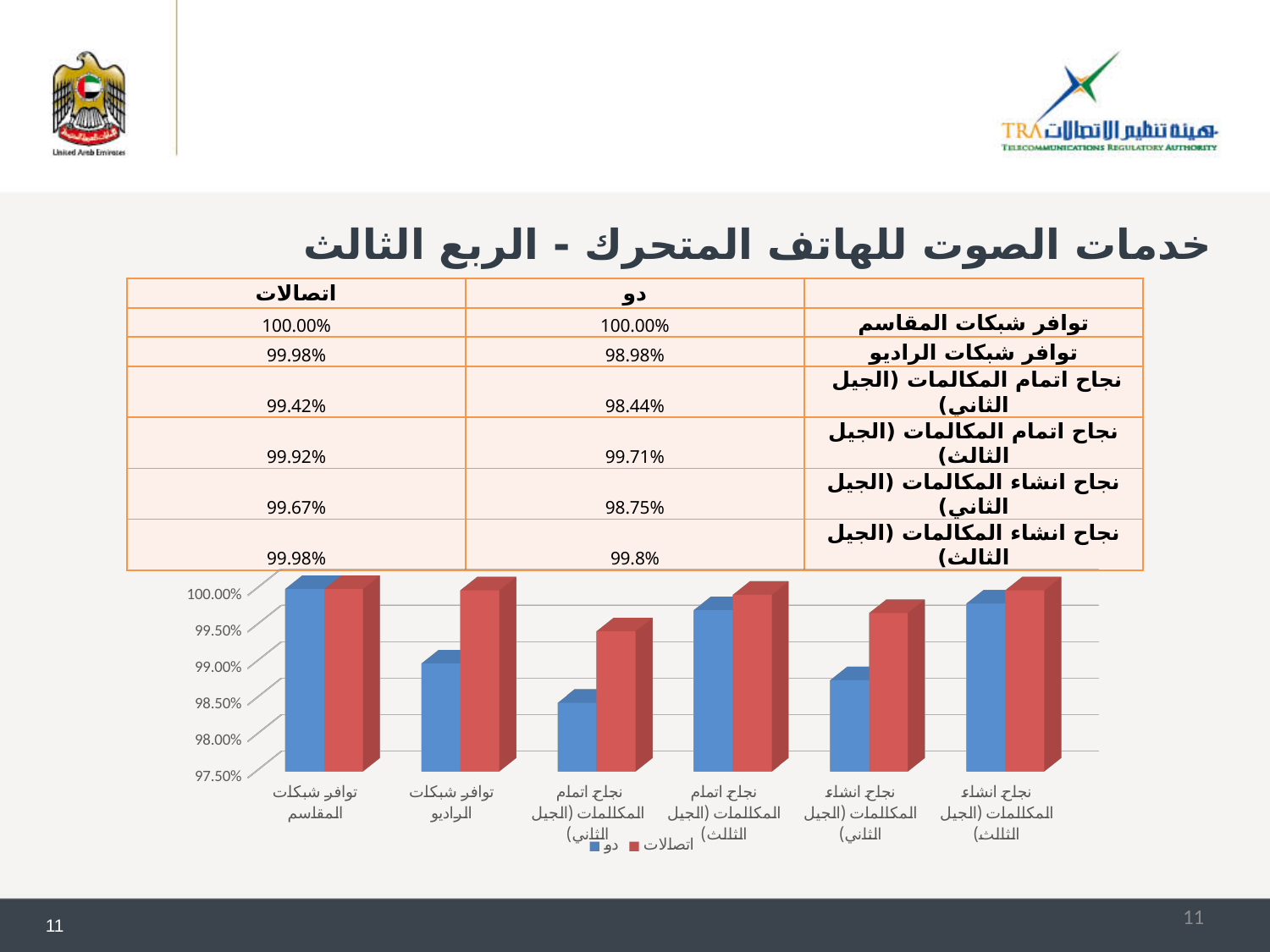
What is the value for دو in the category نجاح انشاء المكالمات (الجيل الثالث)? 99.8% Which category has the lowest value for اتصالات? نجاح اتمام المكالمات (الجيل الثاني) What is the value for دو in the category توافر شبكات الراديو? 98.98% What kind of chart is shown on the slide? Bar chart How many categories are shown on the x axis of the chart? 6 Which is larger in the category نجاح اتمام المكالمات (الجيل الثالث): دو or اتصالات? اتصالات What is the value for اتصالات in the category نجاح اتمام المكالمات (الجيل الثاني)? 99.42% How many series does the chart legend list? 2 Is the value for دو in the category نجاح انشاء المكالمات (الجيل الثاني) greater or less than 99.00%? less Which category has the lowest value for دو? نجاح اتمام المكالمات (الجيل الثاني) What is the difference between اتصالات and دو in the category نجاح انشاء المكالمات (الجيل الثاني)? 0.92% Which series is shown in blue in the chart? دو